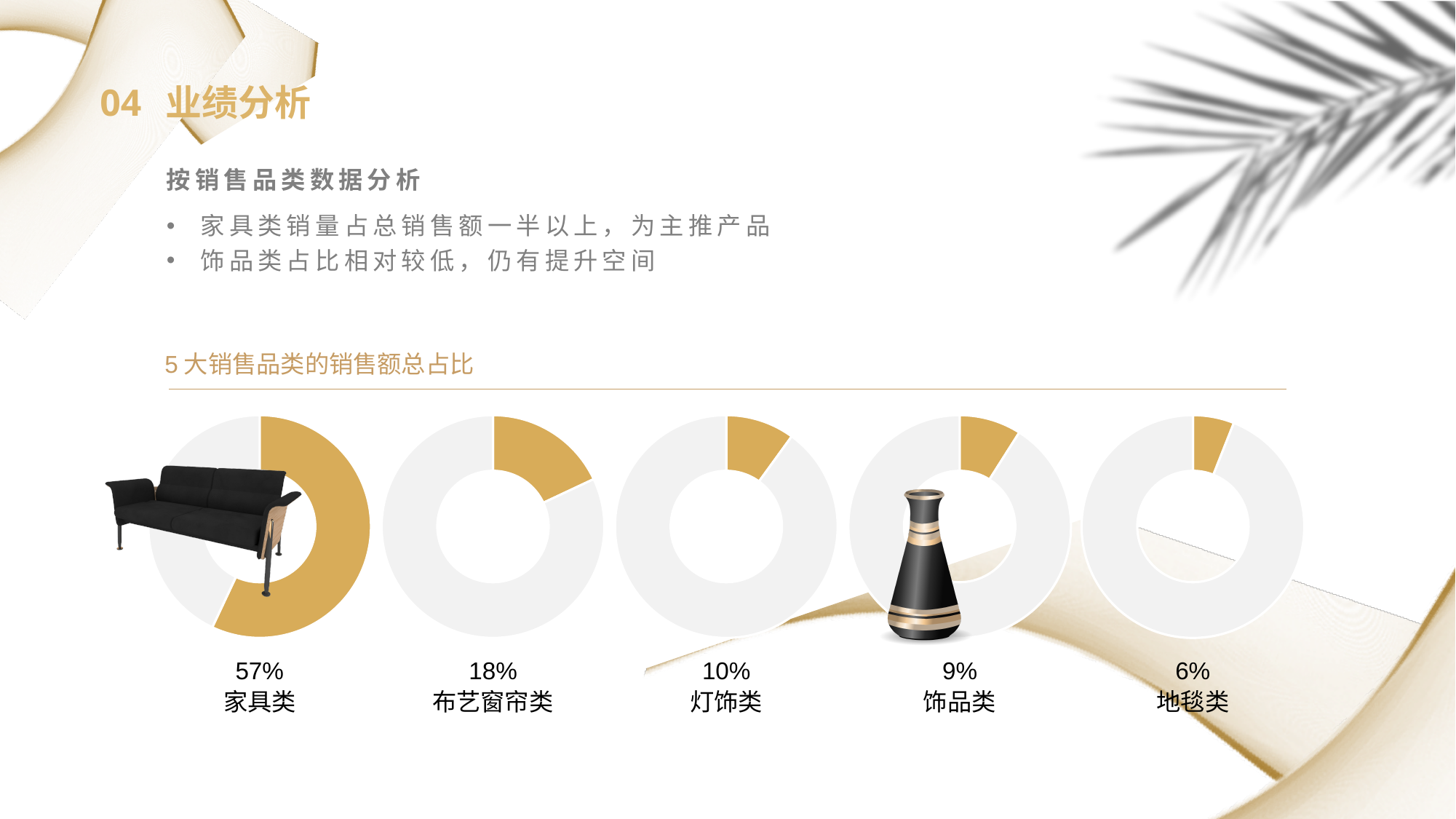
Comparing the donut charts for 家具类 and 布艺窗帘类, what is the difference between their percentages? 39% In the donut chart for 饰品类, what percentage is shown? 9% In the donut chart for 灯饰类, what percentage is shown? 10% What kind of chart is used to show each category's share under '5 大销售品类的销售额总占比'? Donut chart How many donut charts are shown under the heading '5 大销售品类的销售额总占比'? 5 Across the five donut charts under '5 大销售品类的销售额总占比', which category has the lowest share? 地毯类 In the donut chart for 布艺窗帘类, what percentage is shown? 18% In the donut chart for 家具类, what share of total sales does 家具类 account for? 57% What is the heading above the five donut charts? 5 大销售品类的销售额总占比 Comparing the donut charts for 灯饰类 and 饰品类, which category has the larger share? 灯饰类 Across the five donut charts under '5 大销售品类的销售额总占比', which category has the highest share? 家具类 In the donut chart for 地毯类, what percentage is shown? 6%